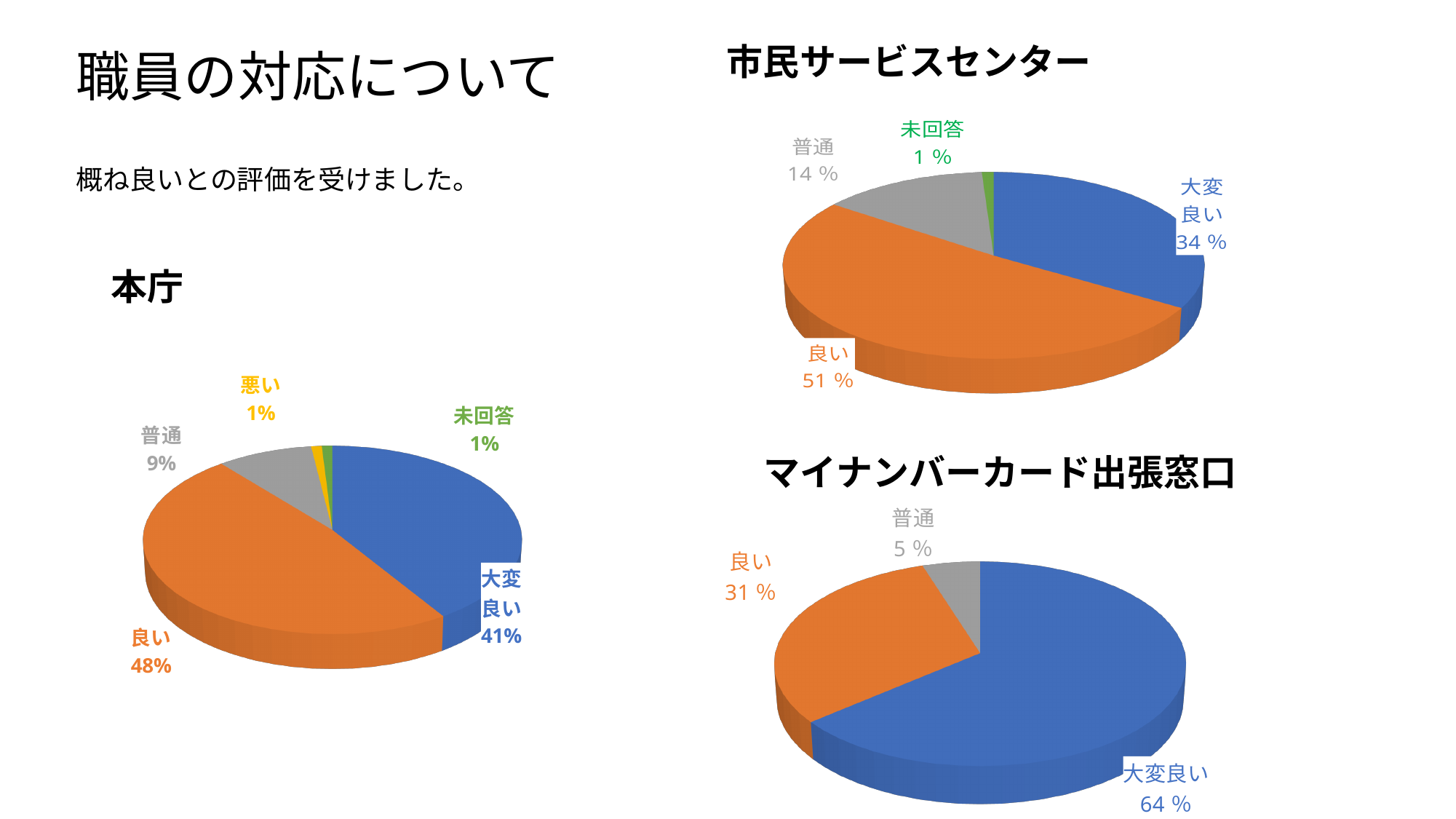
In the 市民サービスセンター chart, what share is labelled for 普通? 14 % In the 市民サービスセンター chart, how many categories are shown? 4 In the 本庁 chart, how many slices does the pie have? 5 In the マイナンバーカード出張窓口 chart, what share is labelled for 大変良い? 64 % In the マイナンバーカード出張窓口 chart, what is the difference between the 大変良い and 良い shares? 33 % In the マイナンバーカード出張窓口 chart, which category has the smallest slice? 普通 In the 本庁 chart, what share is labelled for 良い? 48% In the 本庁 chart, which category has the largest slice? 良い What type of chart is used for the 本庁 data? Pie chart In the 市民サービスセンター chart, which category has the smallest slice? 未回答 In the 本庁 chart, what is the difference between the 良い and 大変良い shares? 7% In the 市民サービスセンター chart, which is larger, 良い or 大変良い? 良い